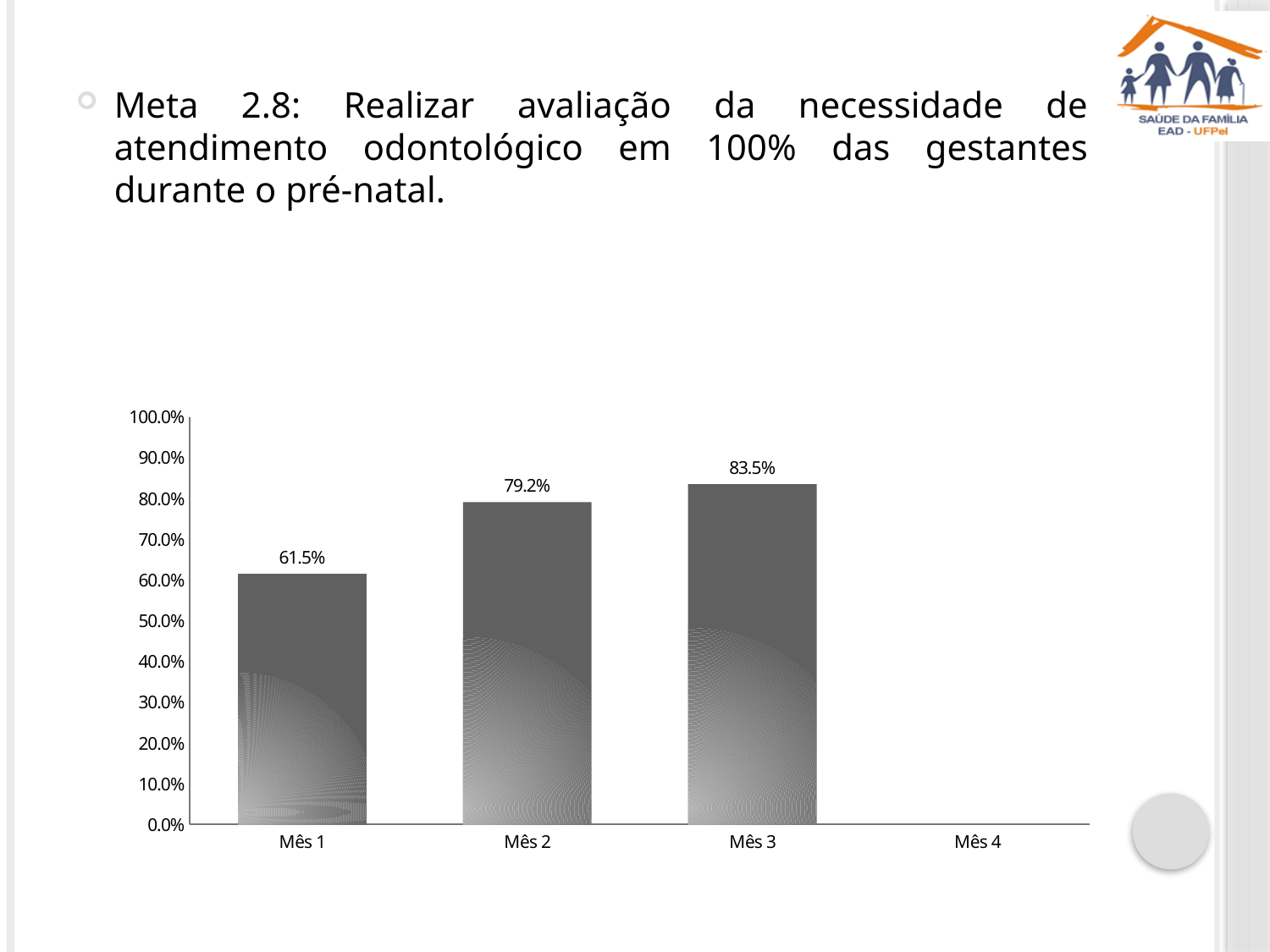
Do the values rise or fall from Mês 1 to Mês 3? rise What is the difference between the values for Mês 2 and Mês 1? 17.7% What is the value for Mês 3? 83.5% Which is larger, the value for Mês 2 or the value for Mês 3? Mês 3 What is the value for Mês 2? 79.2% Among the months with a plotted bar, which has the lowest value? Mês 1 What kind of chart is shown on the slide? bar chart Which month has the highest value? Mês 3 What is the difference between the values for Mês 3 and Mês 1? 22.0% Is the value for Mês 1 greater or less than 70.0%? less What is the value for Mês 1? 61.5% How many categories are shown on the x axis? 4